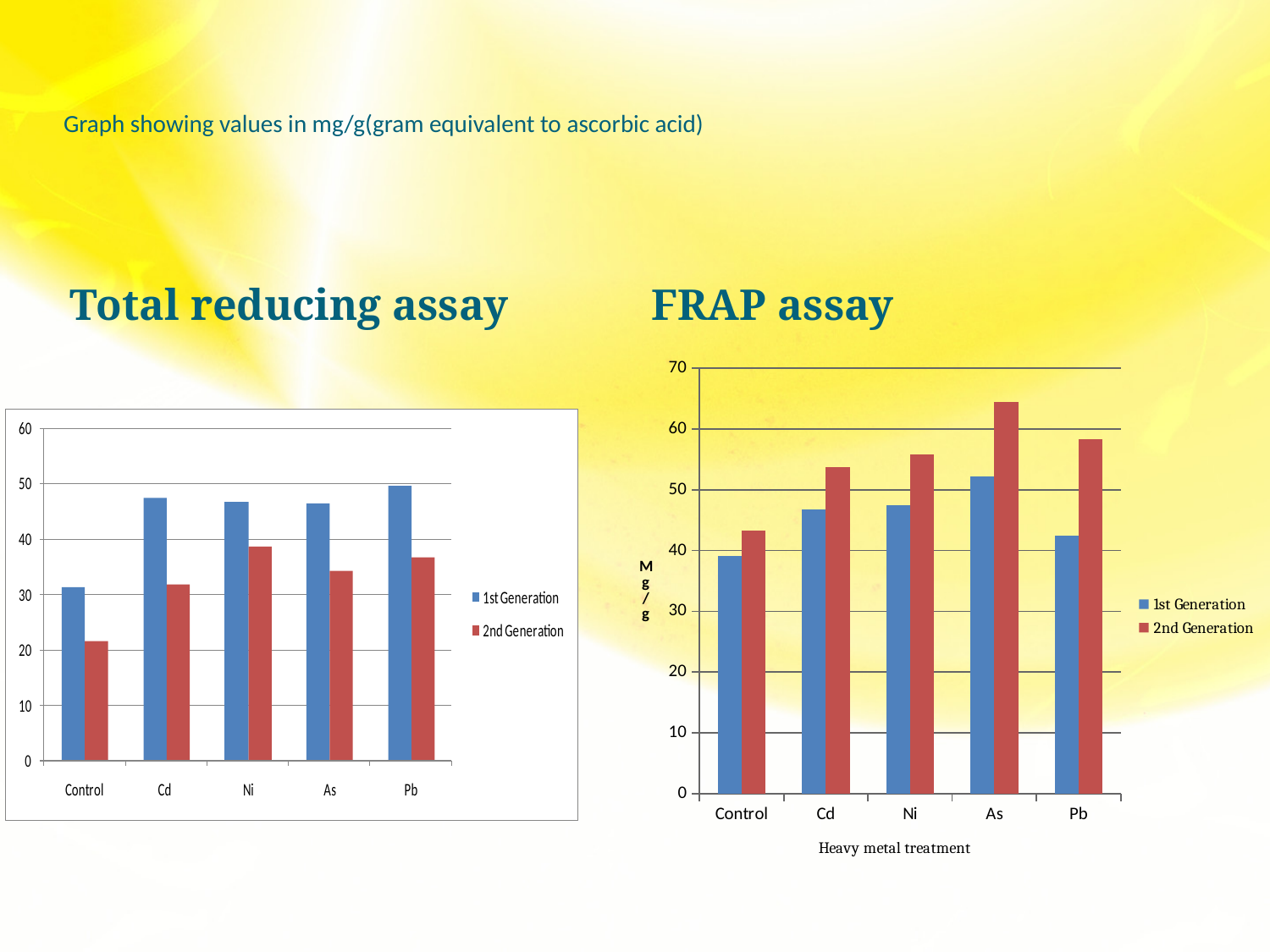
What kind of chart is the Total reducing assay chart? bar chart What is the x-axis title of the FRAP assay chart? Heavy metal treatment In the FRAP assay chart, is the 2nd Generation value for As greater or less than 60? greater In the FRAP assay chart, which category has the lowest 2nd Generation value? Control In the FRAP assay chart, for Control, which is larger: 1st Generation or 2nd Generation? 2nd Generation In the Total reducing assay chart, which category has the lowest 1st Generation value? Control In the FRAP assay chart, which category has the highest 2nd Generation value? As In the Total reducing assay chart, is the 1st Generation value for Pb greater or less than 40? greater In the Total reducing assay chart, is the 2nd Generation value for Control greater or less than 30? less How many heavy metal treatment categories are shown on the x axis of the FRAP assay chart? 5 In the Total reducing assay chart, for Pb, which is larger: 1st Generation or 2nd Generation? 1st Generation How many series does the legend of the FRAP assay chart list? 2